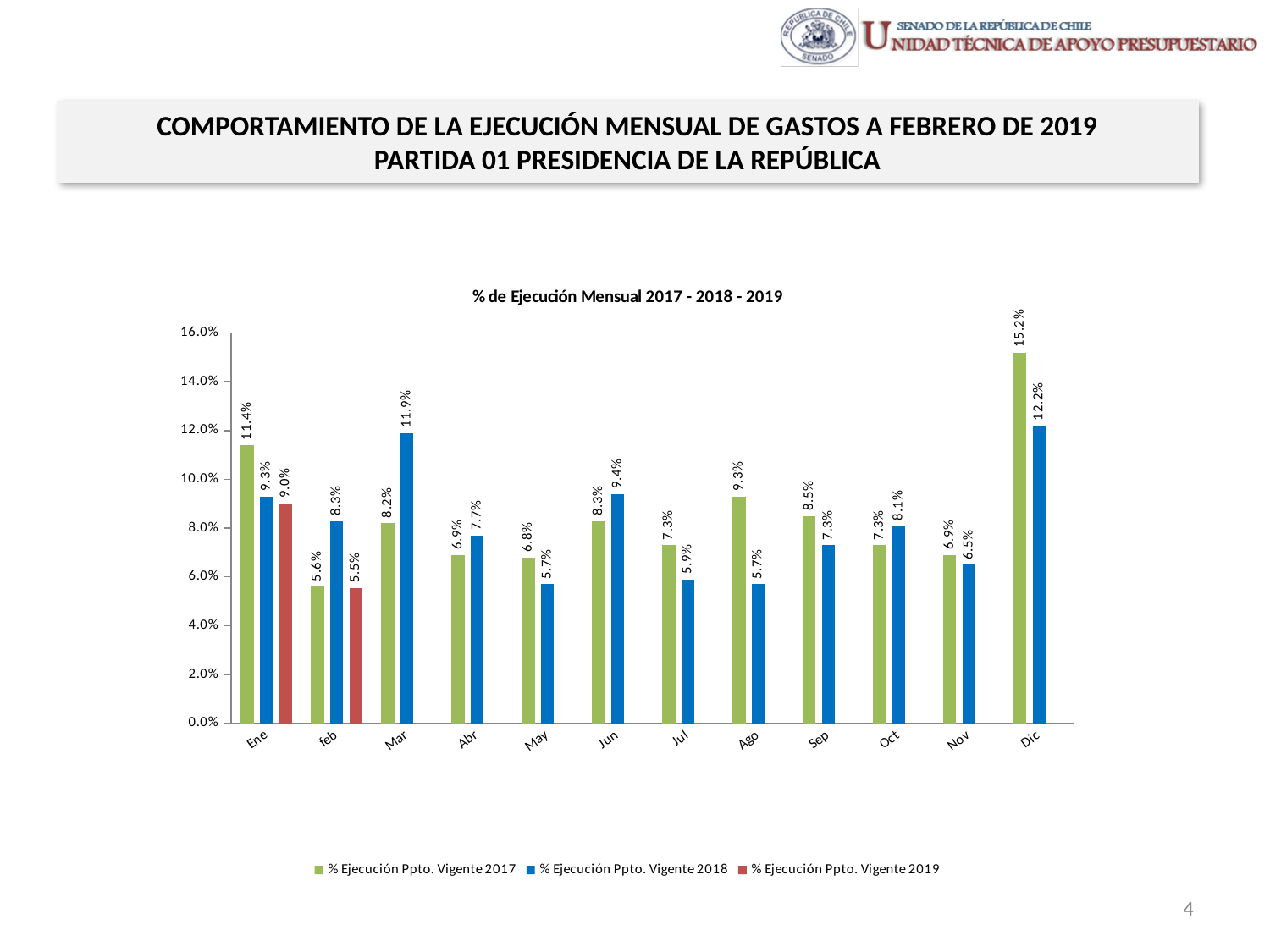
Which is larger for feb: the 2017 value or the 2018 value? 2018 (8.3%) How many months are shown on the x axis? 12 What is the difference between the 2017 and 2018 values for Dic? 3.0% What is the % Ejecución Ppto. Vigente 2018 value for Mar? 11.9% Which month has the highest % Ejecución Ppto. Vigente 2017 value? Dic Which month has the lowest % Ejecución Ppto. Vigente 2017 value? feb Is the % Ejecución Ppto. Vigente 2018 value for Dic greater or less than 10.0%? greater What is the title of the chart? % de Ejecución Mensual 2017 - 2018 - 2019 How many series does the legend list? 3 What kind of chart is shown on the slide? Bar chart What is the % Ejecución Ppto. Vigente 2019 value for Ene? 9.0% What is the % Ejecución Ppto. Vigente 2017 value for Ago? 9.3%